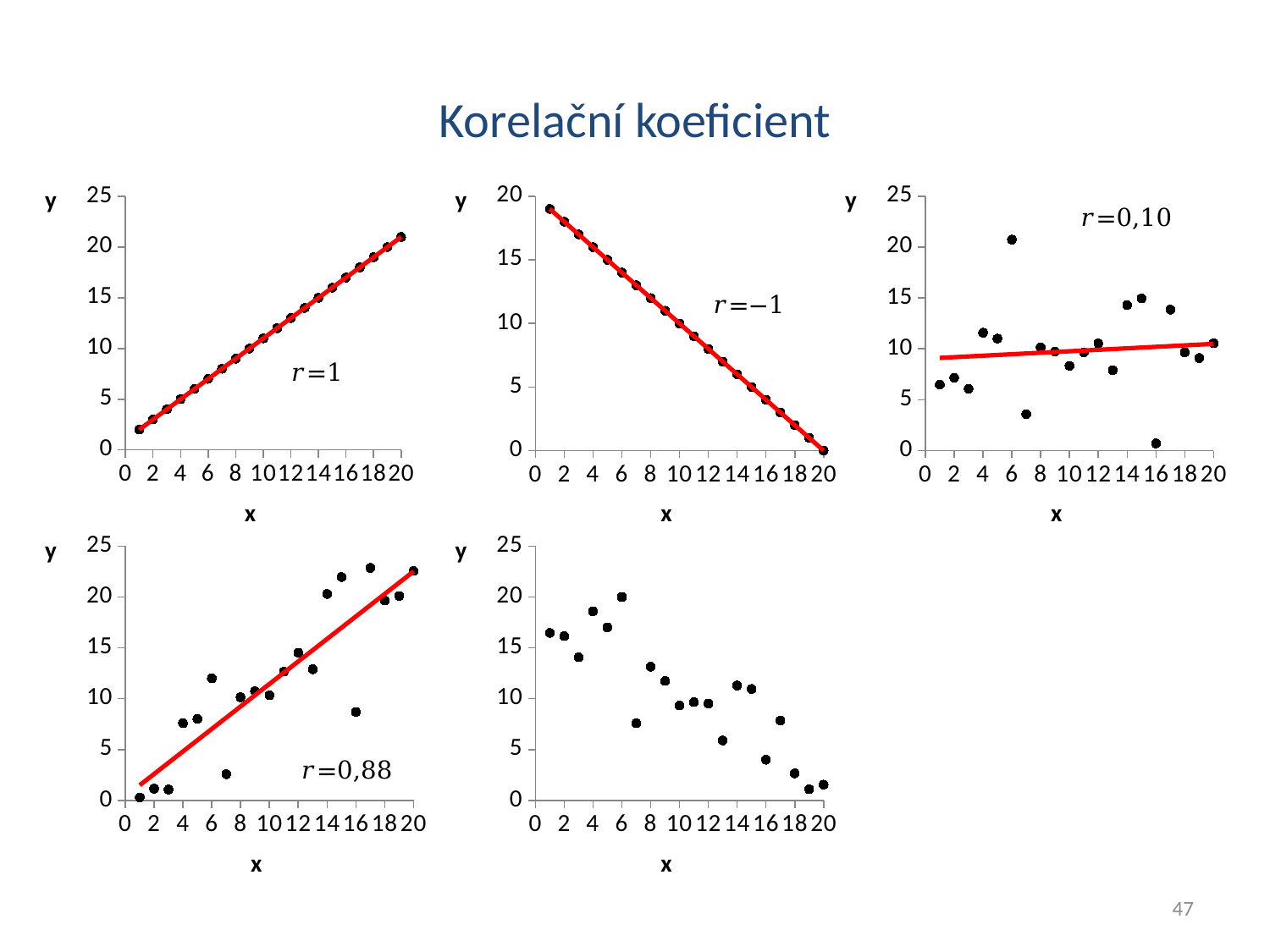
In the top-middle chart labelled r=−1, is the y value at x=1 greater or less than 15? greater What kind of chart is the top-left chart labelled r=1? scatter chart How many charts are shown on the slide? 5 In the top-left chart labelled r=1, do the y values rise or fall as x increases? rise In the bottom-left chart labelled r=0,88, is the y value at x=1 greater or less than 5? less In the bottom-middle chart (the one without an r label), is the y value at x=19 greater or less than 5? less In the top-middle chart labelled r=−1, do the y values rise or fall as x increases? fall In the bottom-left chart labelled r=0,88, do the y values generally rise or fall as x increases? rise What correlation coefficient value is annotated on the top-right chart? r=0,10